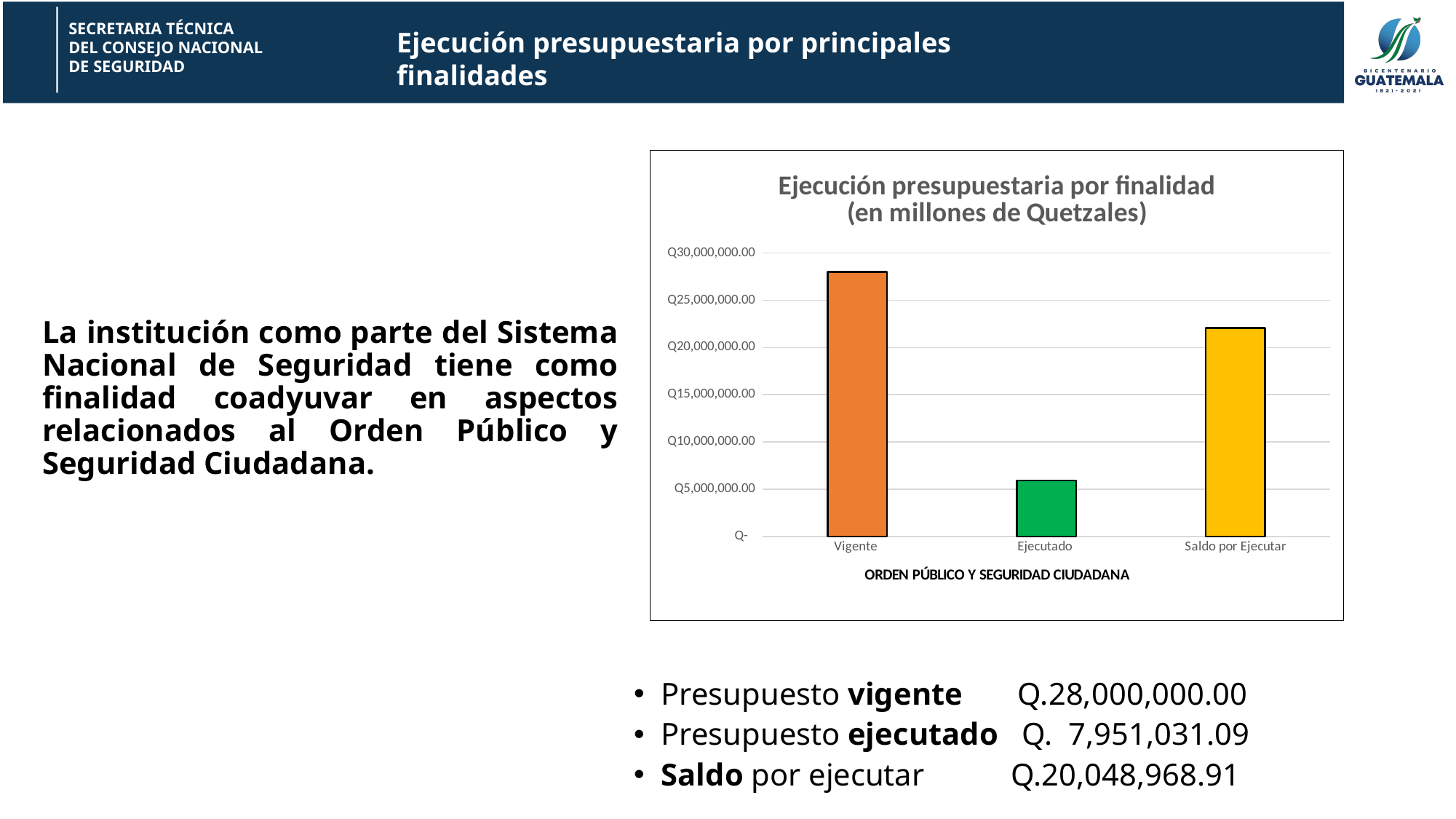
What is the title of the chart? Ejecución presupuestaria por finalidad (en millones de Quetzales) Is the value for Saldo por Ejecutar greater or less than Q25,000,000.00? less What colour is the bar for Ejecutado? green Which is larger in the chart, Vigente or Saldo por Ejecutar? Vigente Which category has the lowest bar in the chart? Ejecutado Is the value for Vigente greater or less than Q25,000,000.00? greater What kind of chart is shown on the slide? bar chart How many categories are plotted in the chart? 3 Is the value for Saldo por Ejecutar greater or less than Q15,000,000.00? greater Which category has the highest bar in the chart? Vigente Which is larger in the chart, Ejecutado or Saldo por Ejecutar? Saldo por Ejecutar